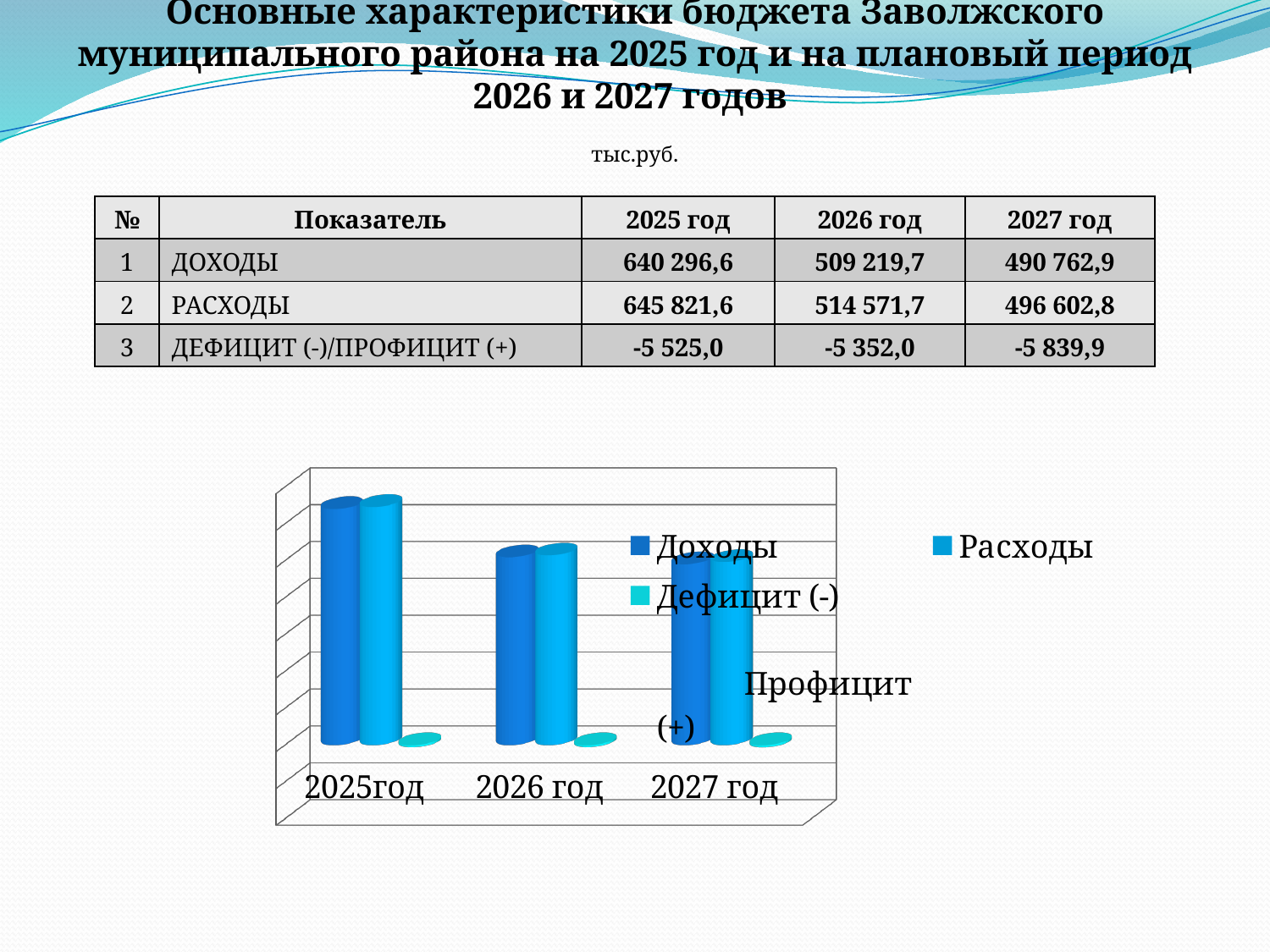
According to the table on the slide, what is the value of РАСХОДЫ for 2027 год? 496 602,8 What kind of chart is shown on the slide? bar chart In which year is the Расходы bar the lowest? 2027 год Which is larger in the chart: Доходы for 2025 год or Доходы for 2026 год? 2025 год Which series in the chart has the smallest bars in every year? Дефицит (-) Профицит (+) Do the Доходы bars rise or fall from 2025 год to 2027 год? fall How many series does the chart legend list? 3 According to the table on the slide, what is the value of ДОХОДЫ for 2025 год? 640 296,6 Which series is shown in the darkest blue in the chart legend? Доходы According to the table on the slide, what is the ДЕФИЦИТ (-)/ПРОФИЦИТ (+) value for 2026 год? -5 352,0 In which year is the Доходы bar the highest? 2025год How many year categories are shown on the x axis of the chart? 3